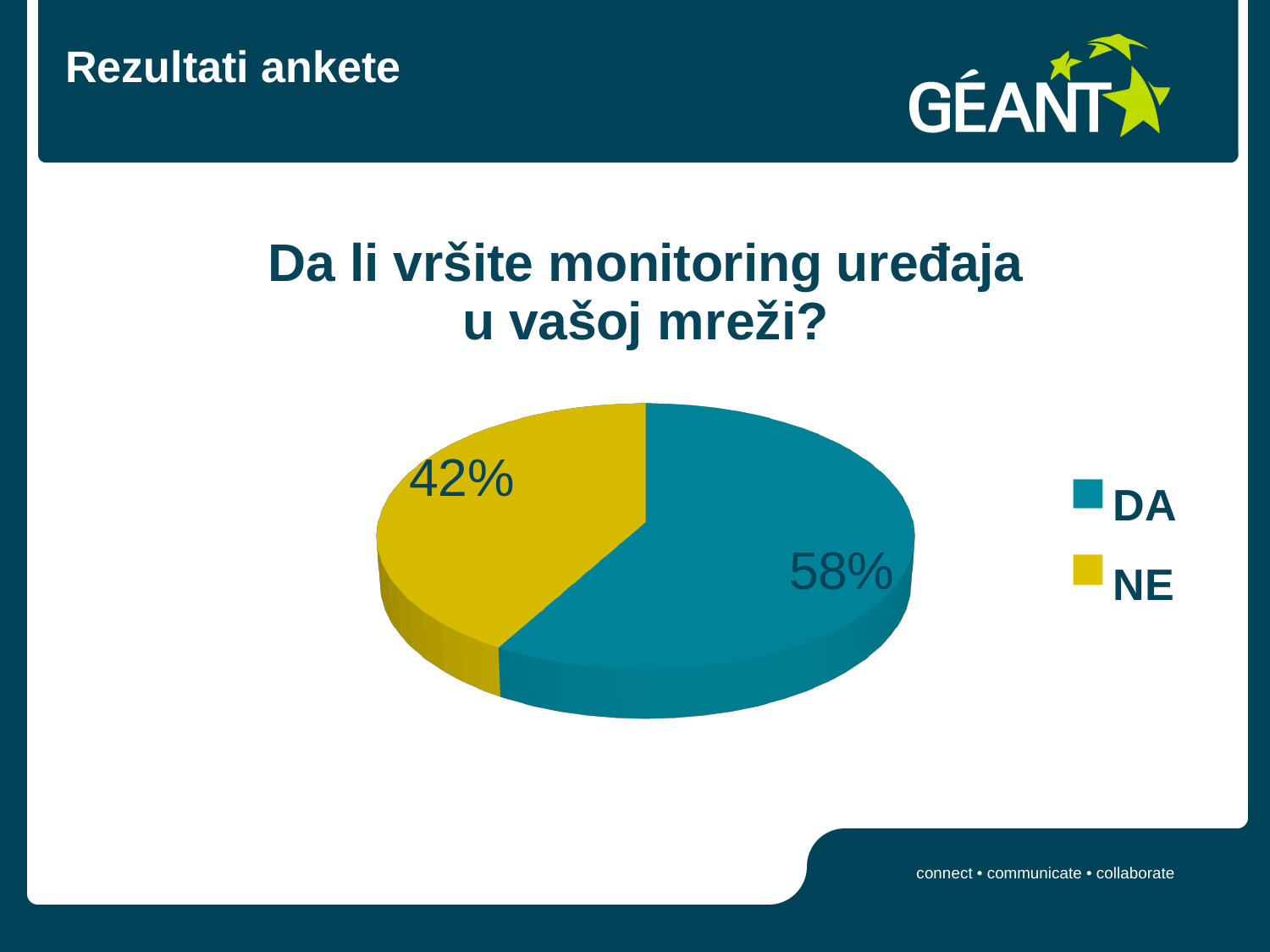
How many entries does the legend list? 2 What colour is the DA slice in the pie chart? Teal Which category has the smallest slice of the pie? NE Is the share for NE greater or less than 50%? less How many slices does the pie chart have? 2 What is the title of the chart? Da li vršite monitoring uređaja u vašoj mreži? What kind of chart is shown on the slide? Pie chart What share of the pie does DA represent? 58% Which is larger, the DA slice or the NE slice? DA What share of the pie does NE represent? 42% What is the difference in percentage points between the DA and NE slices? 16 Which category has the largest slice of the pie? DA